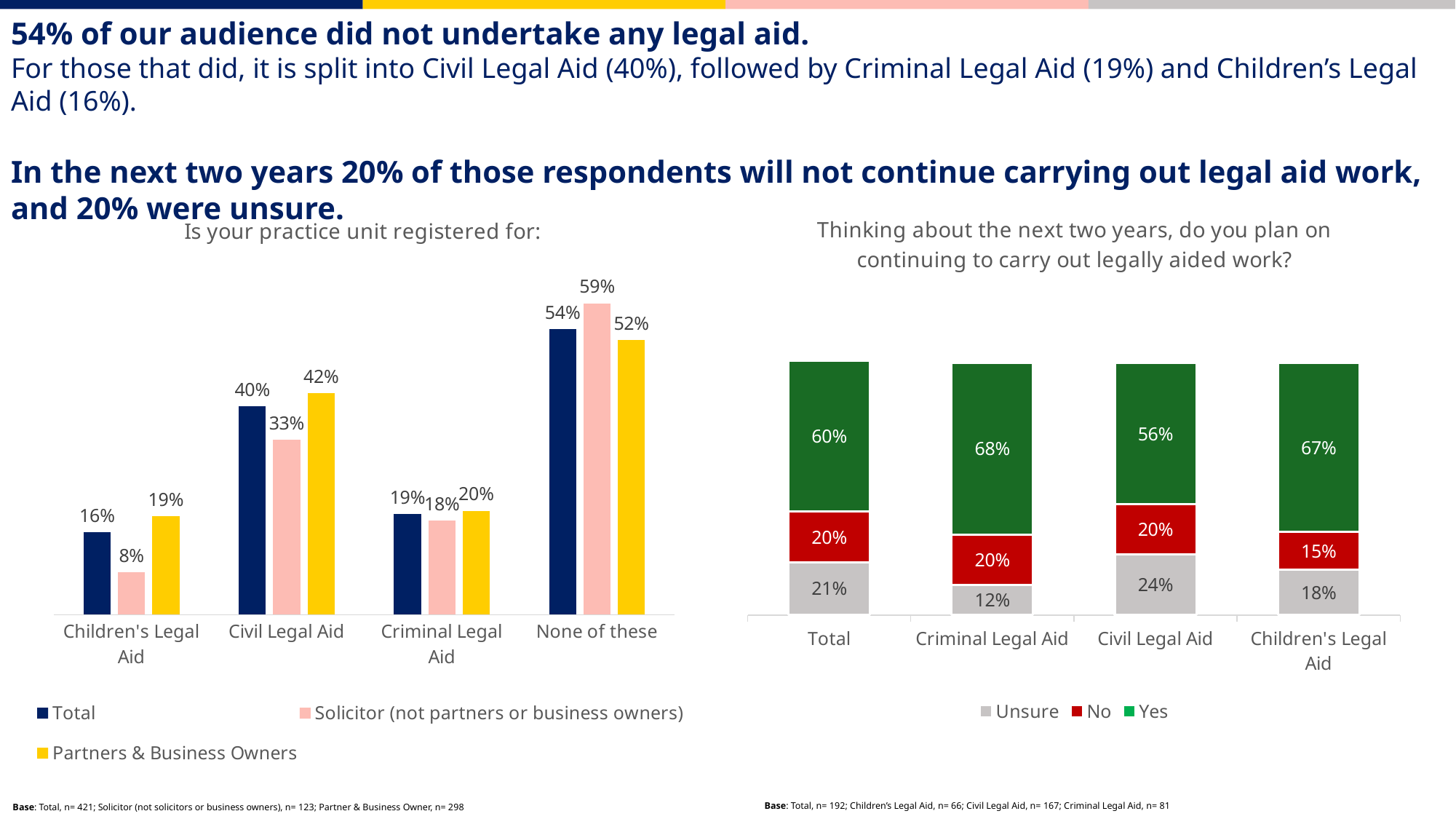
In the chart 'Thinking about the next two years, do you plan on continuing to carry out legally aided work?', which category has the lowest Unsure value? Criminal Legal Aid In the chart 'Is your practice unit registered for:', what is the Total value for Civil Legal Aid? 40% In the chart 'Thinking about the next two years, do you plan on continuing to carry out legally aided work?', what is the Yes value for Criminal Legal Aid? 68% In the chart 'Is your practice unit registered for:', which category has the highest Total value? None of these In the chart 'Thinking about the next two years, do you plan on continuing to carry out legally aided work?', what is the Unsure value for Civil Legal Aid? 24% In the chart 'Is your practice unit registered for:', what is the Solicitor (not partners or business owners) value for Children's Legal Aid? 8% In the chart 'Is your practice unit registered for:', how many categories are shown on the x axis? 4 In the chart 'Is your practice unit registered for:', what is the difference between the Partners & Business Owners value and the Solicitor value for Civil Legal Aid? 9% In the chart 'Is your practice unit registered for:', how many series does the legend list? 3 What kind of chart is 'Thinking about the next two years, do you plan on continuing to carry out legally aided work?'? Stacked bar chart In the chart 'Thinking about the next two years, do you plan on continuing to carry out legally aided work?', is the Yes value larger for Civil Legal Aid or Children's Legal Aid? Children's Legal Aid In the chart 'Thinking about the next two years, do you plan on continuing to carry out legally aided work?', what colour represents the No series? Red